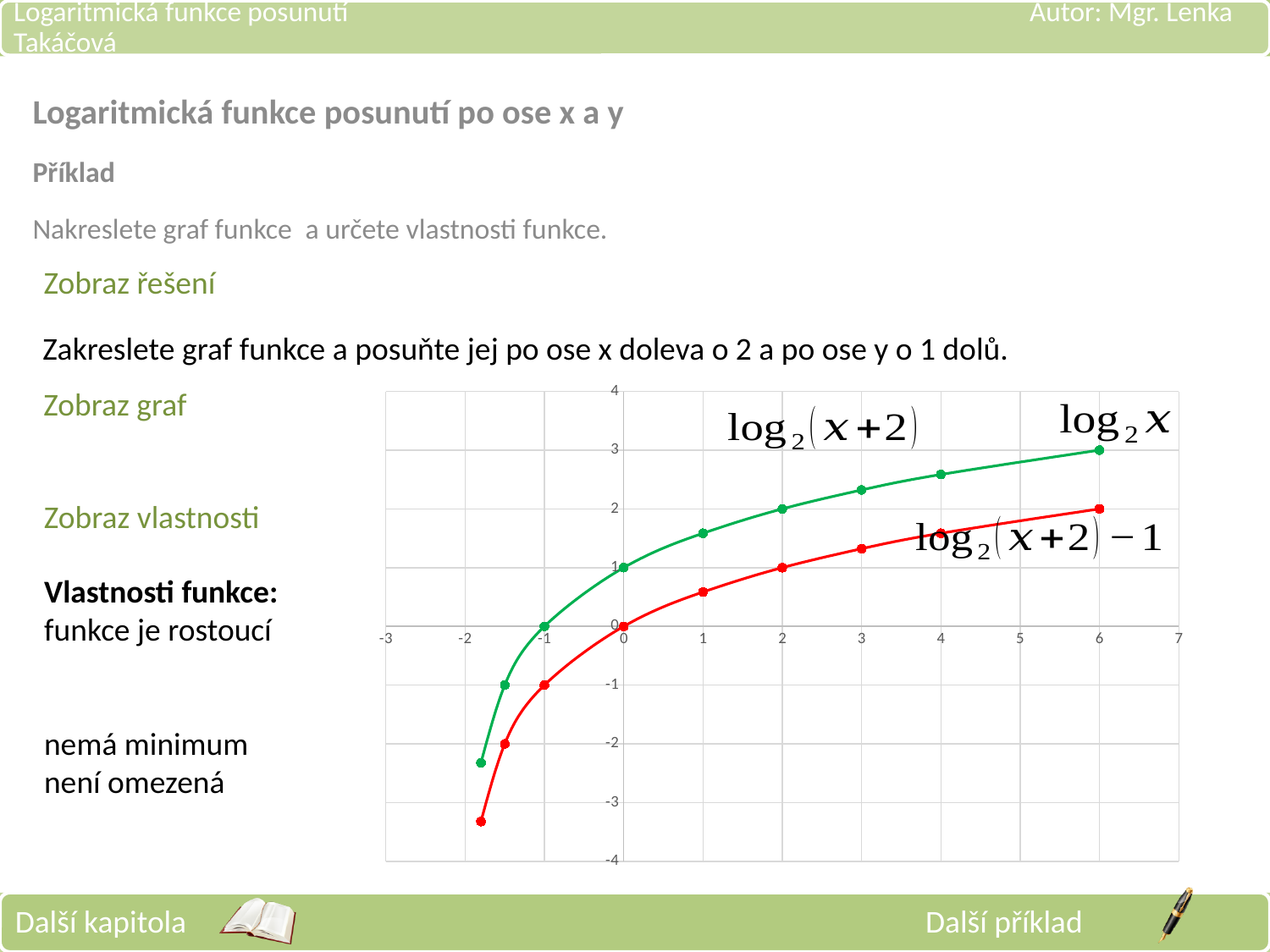
Is the value of the green curve log₂(x+2) at x = 4 greater or less than 2? greater What is the difference between the green curve and the red curve at x = 6? 1 At x = 2, which curve has the larger value, the green log₂(x+2) or the red log₂(x+2)−1? green log₂(x+2) What is the value of the red curve log₂(x+2)−1 at x = 6? 2 Is the value of the red curve log₂(x+2)−1 at x = 1 greater or less than 1? less What is the value of the green curve log₂(x+2) at x = 2? 2 What colour is the curve labelled log₂(x+2)−1? red How many curves (series) are plotted on the chart? 2 What kind of chart is shown on the slide? line chart Do the values of the green curve log₂(x+2) rise or fall as x increases? rise What is the value of the red curve log₂(x+2)−1 at x = 0? 0 What is the value of the green curve log₂(x+2) at x = 6? 3